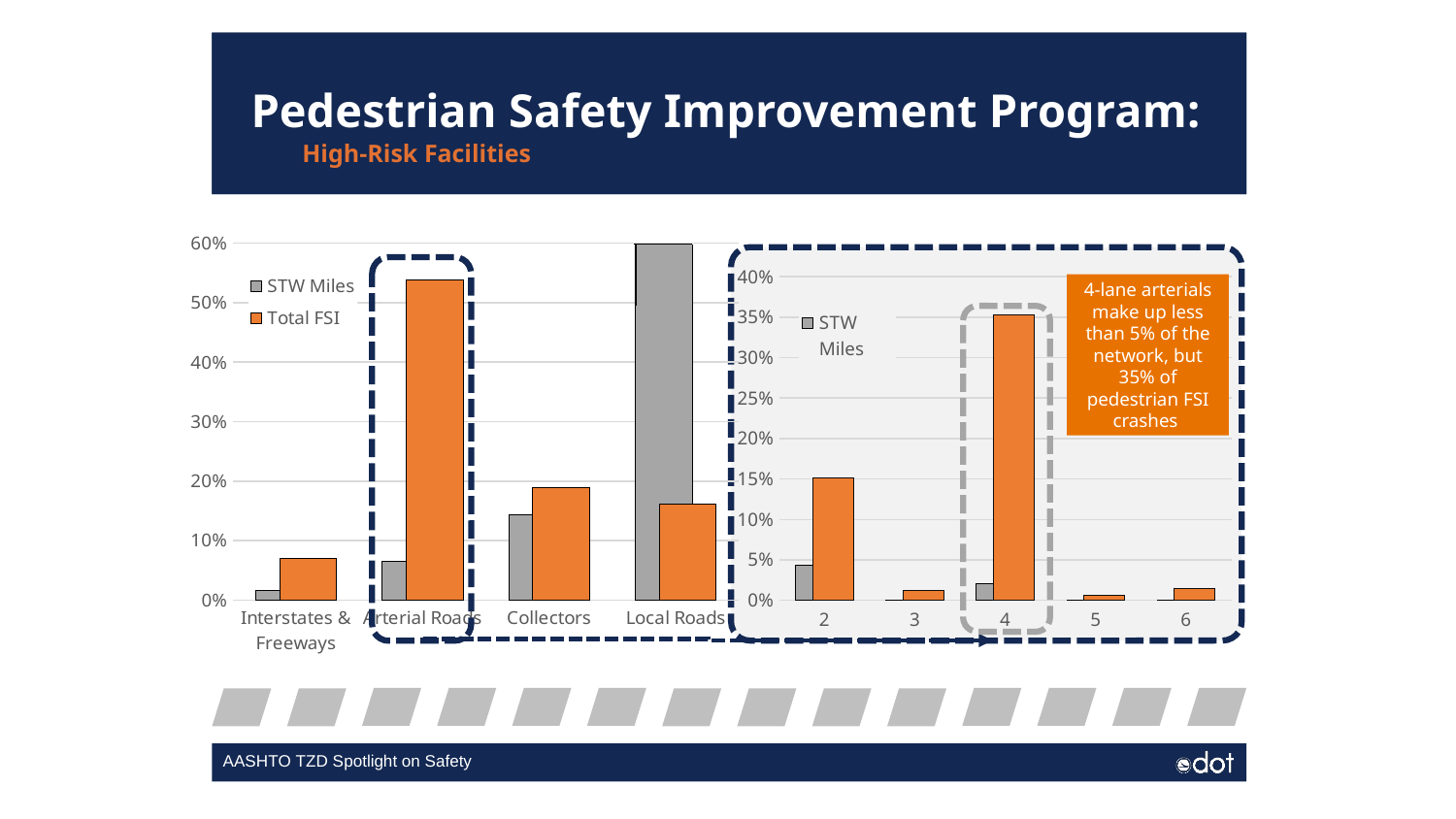
In the left chart, is the STW Miles value for Collectors greater or less than 20%? less How many series does the legend of the left chart list? 2 How many lane categories are shown on the x axis of the inset chart on the right? 5 In the left chart, which road category has the highest STW Miles value? Local Roads What kind of chart is the left chart with categories Interstates & Freeways, Arterial Roads, Collectors and Local Roads? Bar chart In the inset chart on the right, is the orange bar for category 4 greater or less than 30%? greater In the left chart, is the Total FSI value for Arterial Roads greater or less than 50%? greater In the left chart, for Local Roads, which is larger: STW Miles or Total FSI? STW Miles In the left chart, for Interstates & Freeways, which is larger: STW Miles or Total FSI? Total FSI In the inset chart on the right, which lane category has the tallest orange bar? 4 In the left chart, which road category has the highest Total FSI value? Arterial Roads How many road categories are shown on the x axis of the left chart? 4